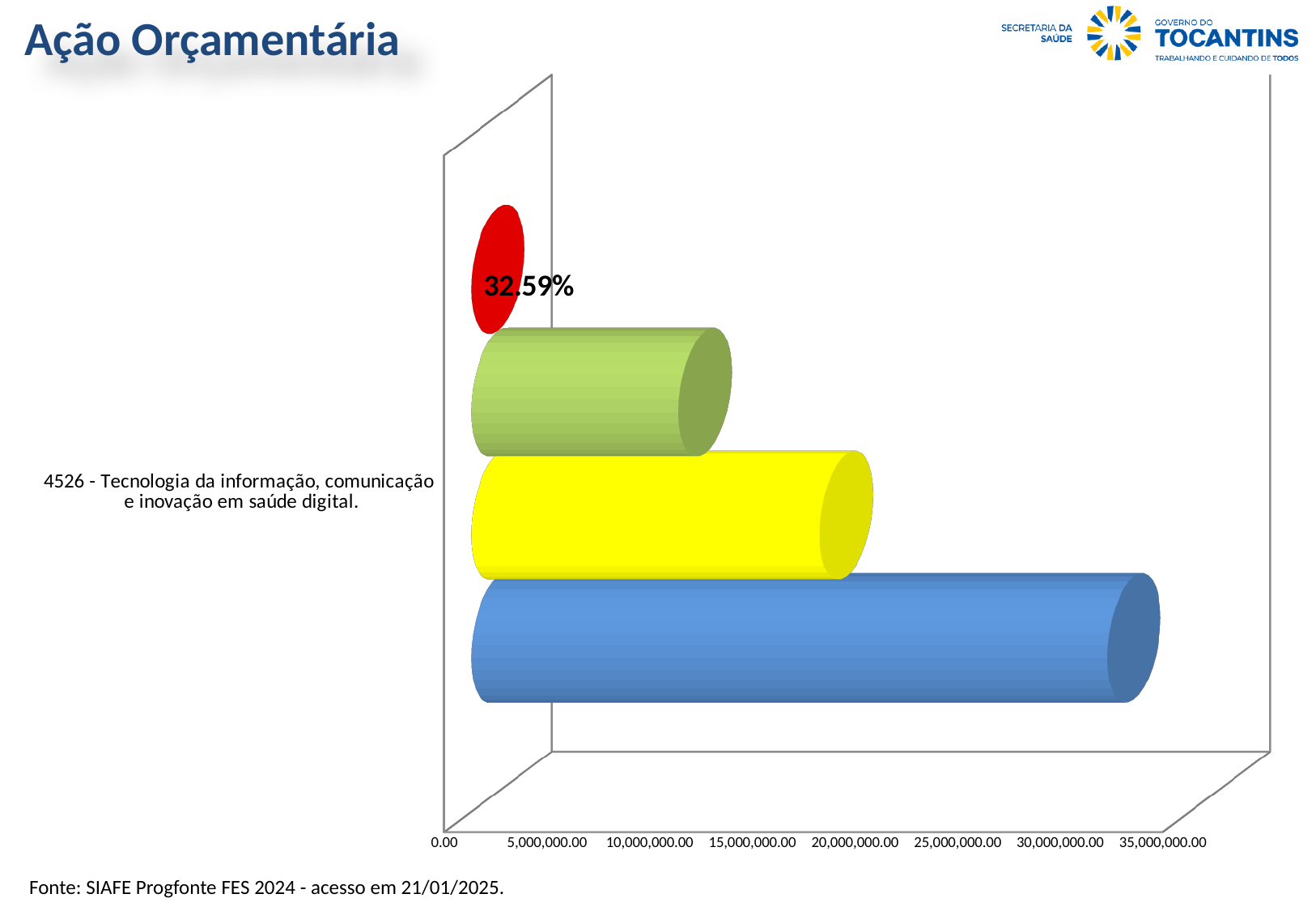
Is the value of the blue bar greater or less than 30,000,000.00? greater What is the highest tick value shown on the horizontal axis? 35,000,000.00 How many categories are shown on the vertical axis of the chart? 1 Is the value of the green bar greater or less than 15,000,000.00? less What is the category label shown on the chart? 4526 - Tecnologia da informação, comunicação e inovação em saúde digital. Which is larger, the blue bar or the yellow bar? blue Which coloured bar is the shortest in the chart? red Which coloured bar is the longest in the chart? blue Is the value of the yellow bar greater or less than 15,000,000.00? greater What data label is printed on the red bar? 32.59% What is the title of the slide containing the chart? Ação Orçamentária What kind of chart is shown on the slide? bar chart